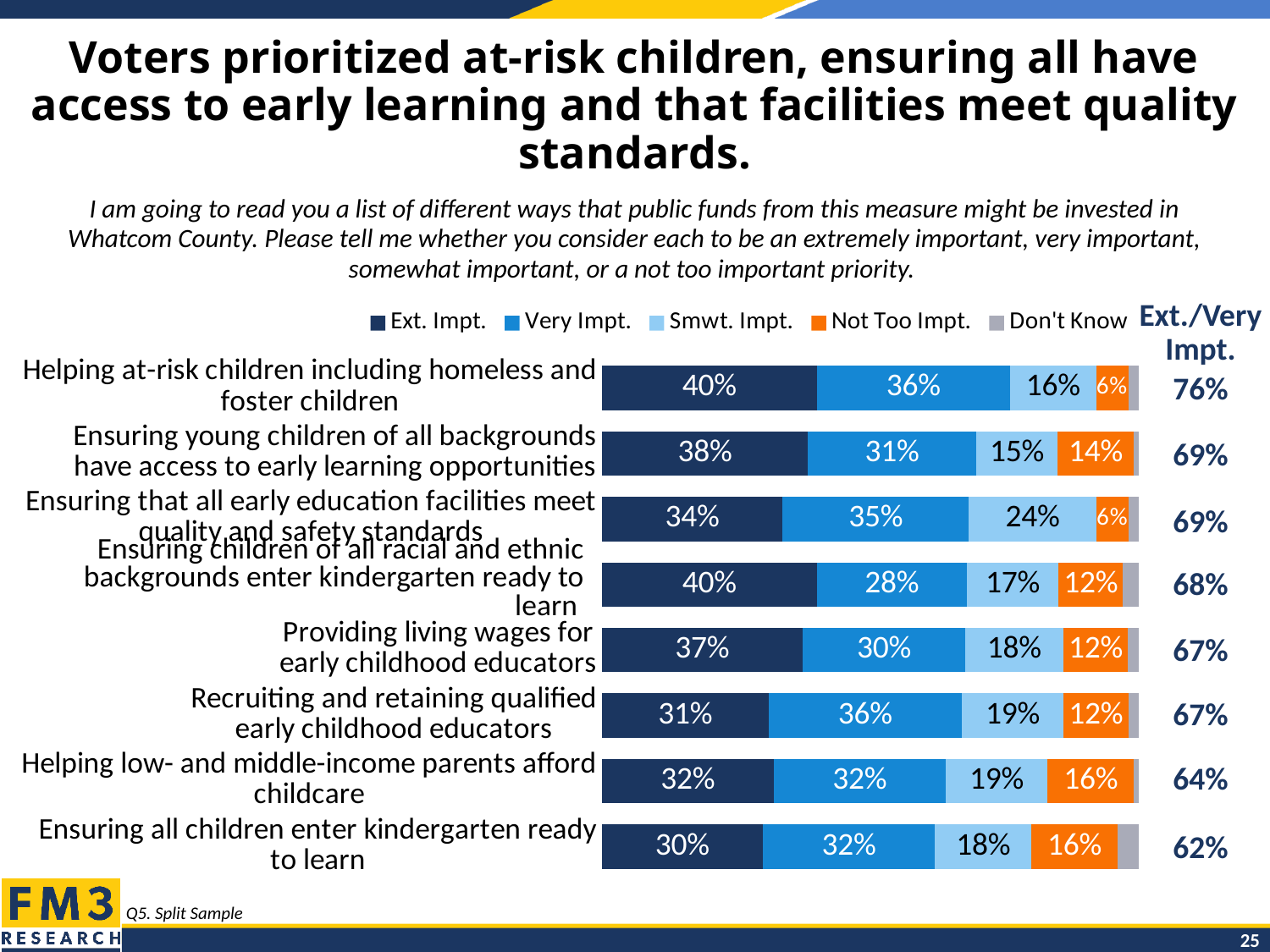
Which series in the legend is shown in orange? Not Too Impt. Which category has the lowest combined Ext./Very Impt. percentage? Ensuring all children enter kindergarten ready to learn What is the 'Smwt. Impt.' value for 'Ensuring that all early education facilities meet quality and safety standards'? 24% How many categories (investment priorities) are plotted in the chart? 8 What is the 'Not Too Impt.' value for 'Helping low- and middle-income parents afford childcare'? 16% What is the difference between the Ext./Very Impt. percentage for 'Helping at-risk children including homeless and foster children' and for 'Ensuring all children enter kindergarten ready to learn'? 14 percentage points Which has a larger 'Ext. Impt.' value: 'Providing living wages for early childhood educators' or 'Recruiting and retaining qualified early childhood educators'? Providing living wages for early childhood educators How many series does the legend list? 5 What kind of chart is shown on the slide? Stacked bar chart What is the 'Very Impt.' value for 'Ensuring that all early education facilities meet quality and safety standards'? 35% Which category has the highest combined Ext./Very Impt. percentage? Helping at-risk children including homeless and foster children What percentage of voters rated 'Helping at-risk children including homeless and foster children' as extremely important? 40%